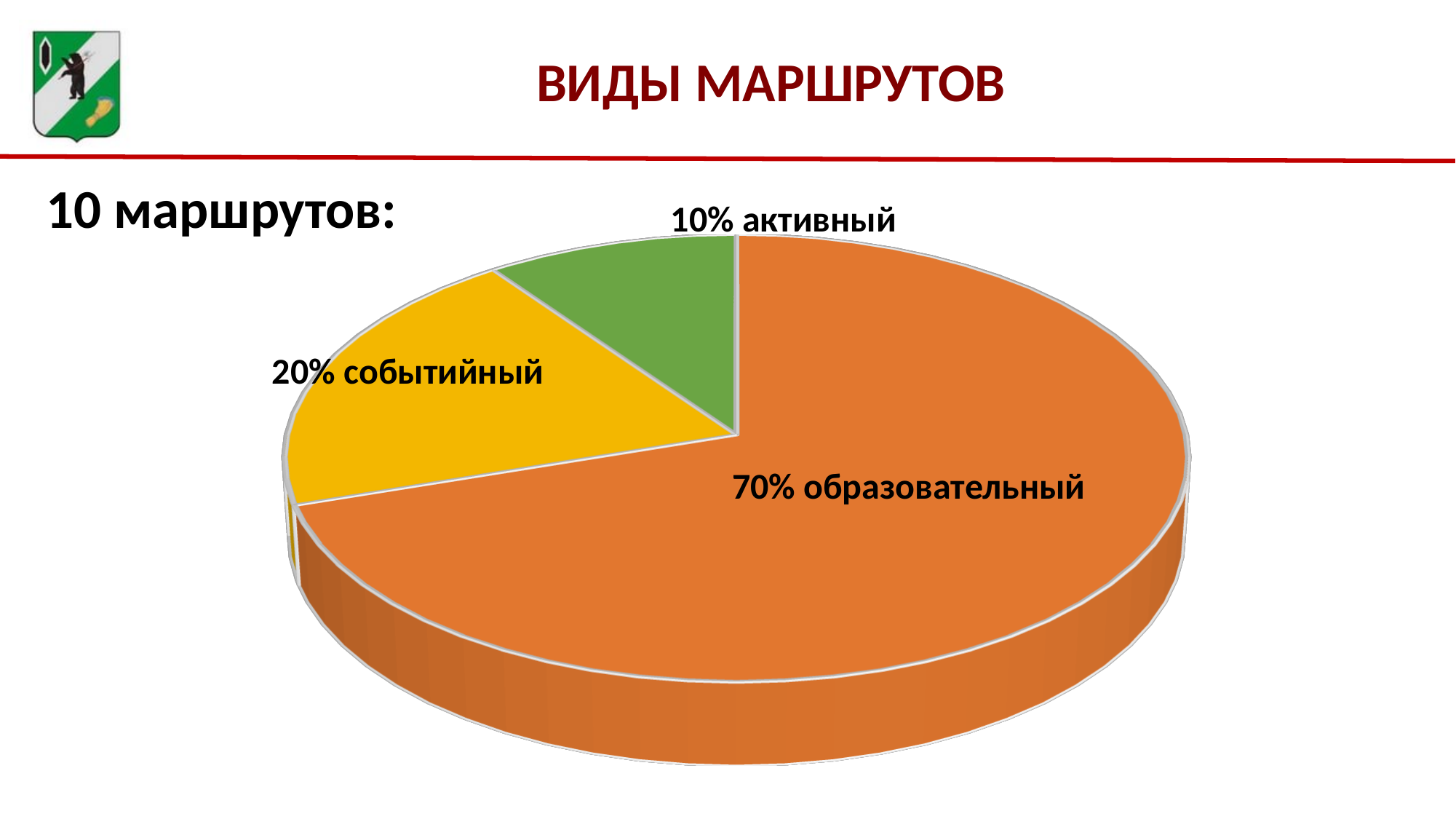
What is the title of the slide containing the pie chart? ВИДЫ МАРШРУТОВ What kind of chart is shown on the slide? pie chart What is the difference in percentage points between the 'событийный' and 'активный' slices? 10% What is the difference in percentage points between the 'образовательный' and 'событийный' slices? 50% How many slices does the pie chart have? 3 What colour is the 'активный' slice of the pie? green What share of the pie does the 'событийный' slice represent? 20% What share of the pie does the 'активный' slice represent? 10% Which slice of the pie is the smallest? активный What share of the pie does the 'образовательный' slice represent? 70% Which is larger, the 'событийный' slice or the 'активный' slice? событийный Which slice of the pie is the largest? образовательный